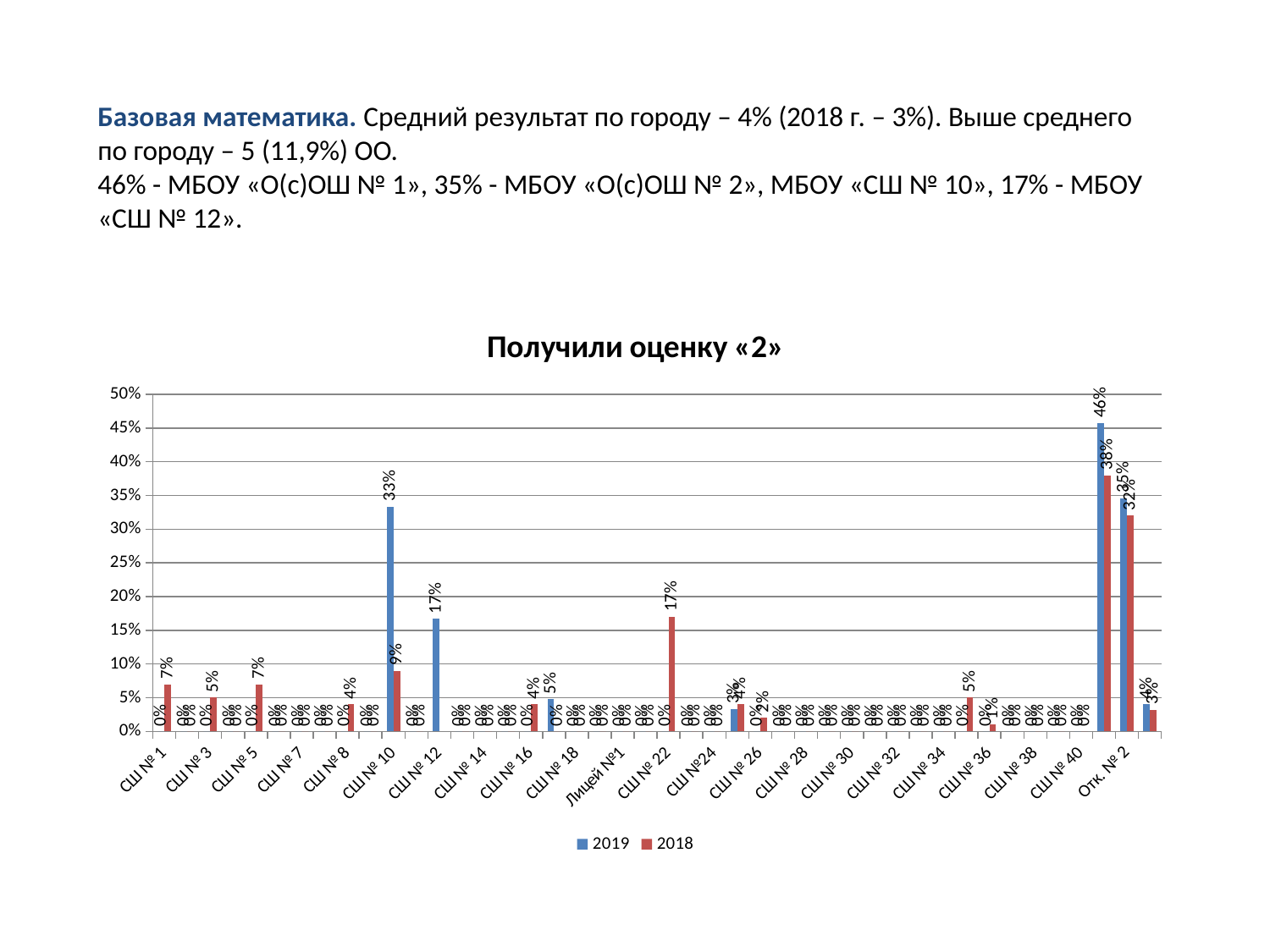
What is the 2018 value for СШ № 10? 9% How many series does the legend list? 2 What is the 2018 value for СШ № 3? 5% By how many percentage points does the 2019 value for СШ № 10 exceed its 2018 value? 24 percentage points What is the 2018 value for СШ № 1? 7% What is the highest value shown anywhere in the chart? 46% What is the 2019 value for СШ № 10? 33% What is the 2019 value for СШ № 12? 17% What are the two series named in the legend? 2019 and 2018 What is the 2018 value for СШ № 22? 17% What is the title of the chart? Получили оценку «2» What kind of chart is shown on the slide? bar chart